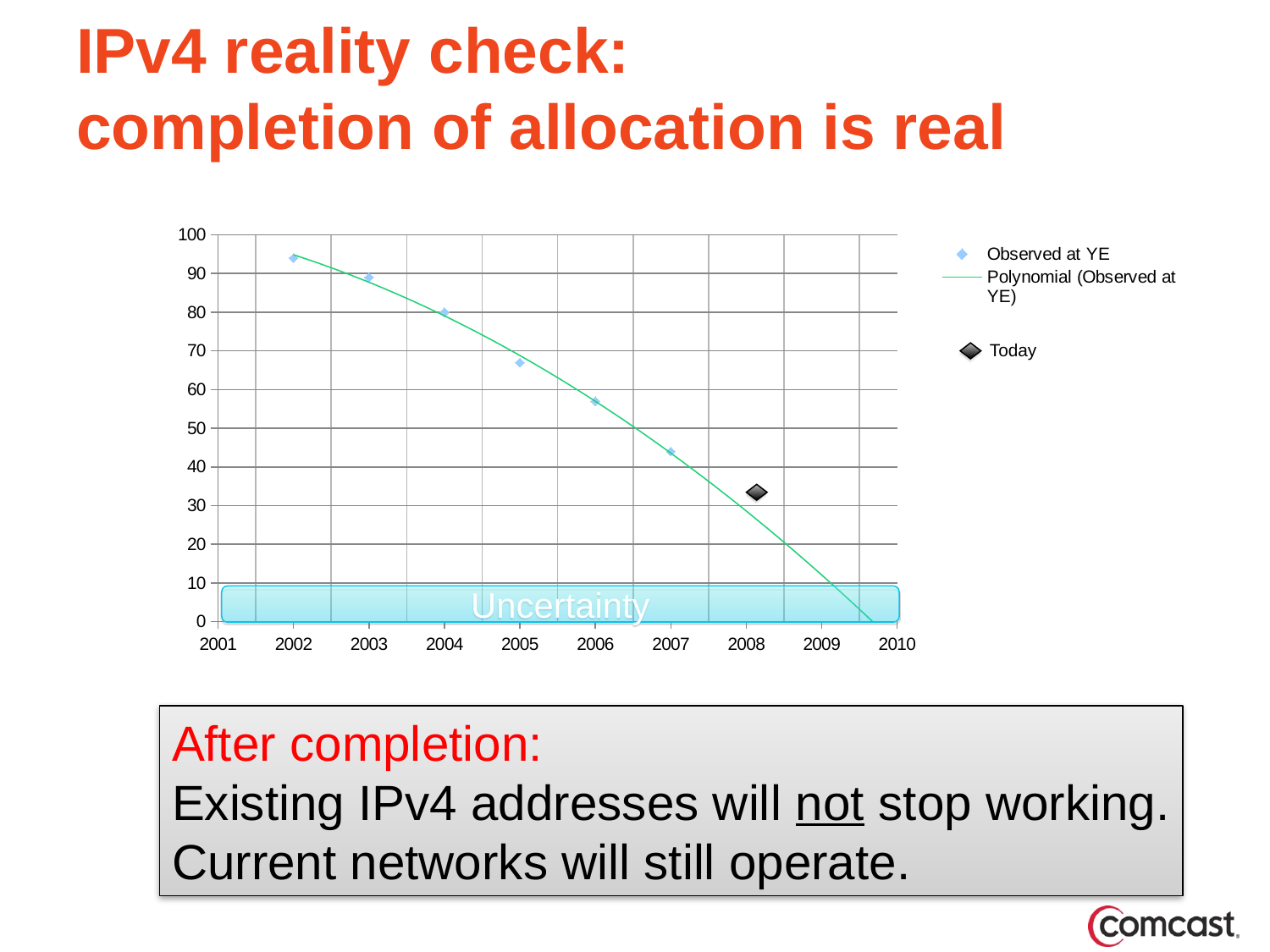
Which year has the larger observed value, 2003 or 2006? 2003 What is the name of the first series listed in the chart legend? Observed at YE Do the observed values rise or fall from 2002 to 2007? Fall How many observed data points are plotted in the chart? 6 Is the observed value for 2002 greater or less than 90? greater Is the observed value for 2006 greater or less than 50? greater Which year has the lowest observed value? 2007 What label is shown in the shaded band along the bottom of the chart? Uncertainty Is the observed value for 2007 greater or less than 50? less Which year has the highest observed value? 2002 What kind of chart is shown on the slide? Scatter chart with a trendline